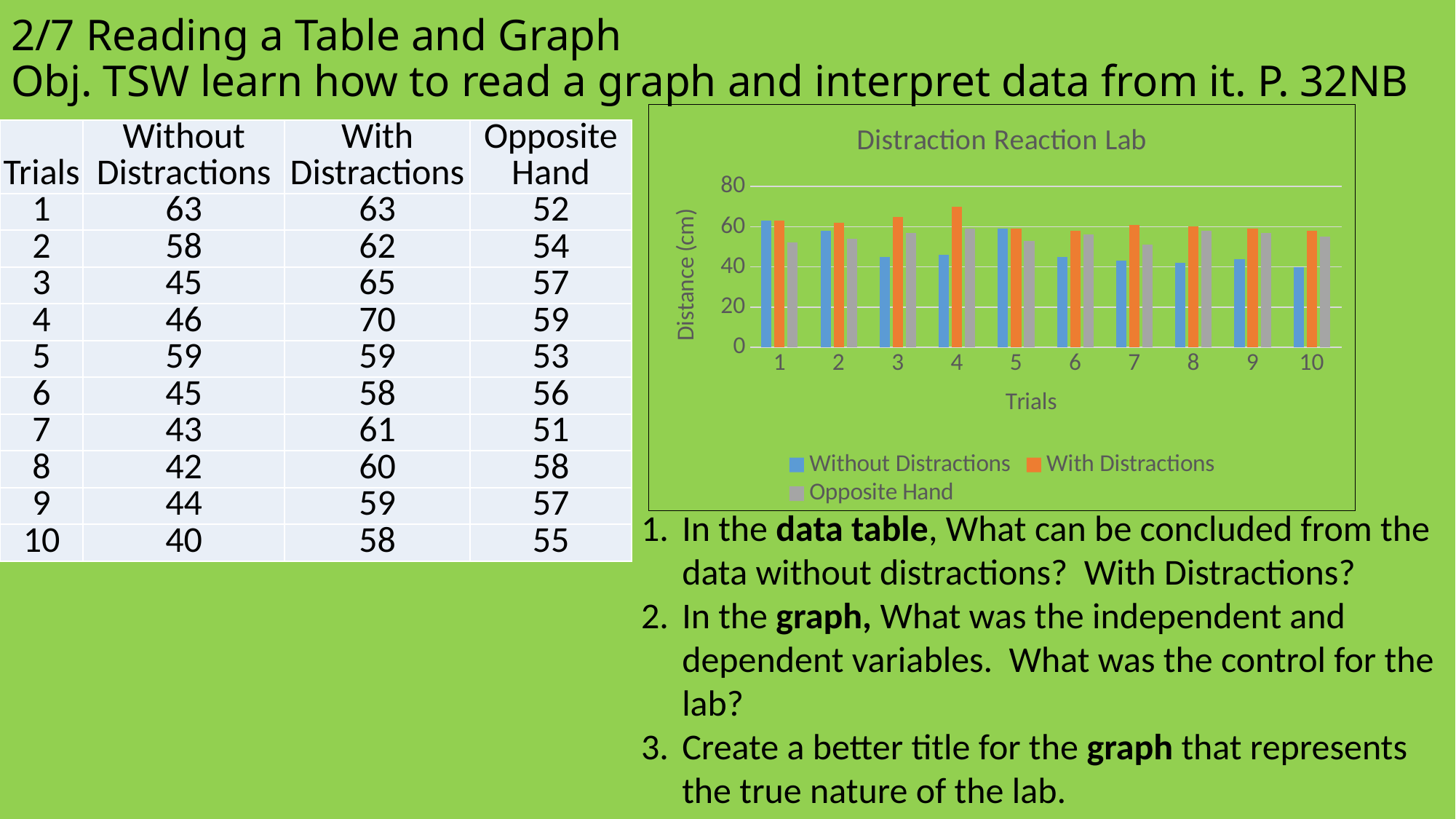
What is the difference between the With Distractions and Without Distractions values for trial 4? 24 How many trials are plotted along the x axis of the chart? 10 For trial 3, which is larger: With Distractions or Without Distractions? With Distractions What kind of chart is shown on the slide? bar chart Is the With Distractions value for trial 4 greater or less than 60? greater At which trial is the With Distractions value highest? 4 What is the title of the chart? Distraction Reaction Lab How many series does the legend of the Distraction Reaction Lab chart list? 3 What is the label on the vertical axis of the chart? Distance (cm) What is the Without Distractions value for trial 1? 63 What is the Opposite Hand value for trial 8? 58 Is the Without Distractions value for trial 10 greater or less than 60? less